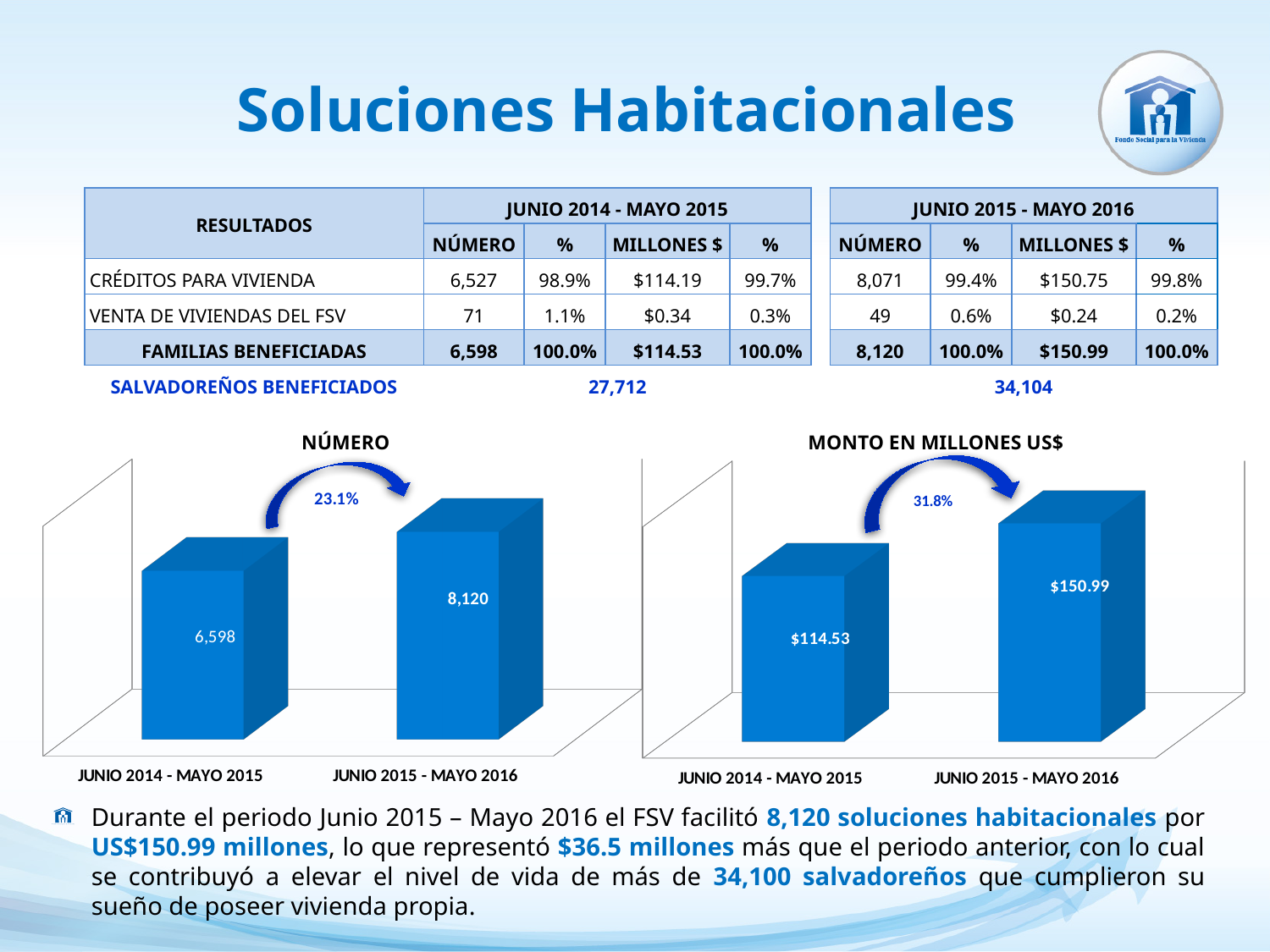
In the NÚMERO chart, what is the value for JUNIO 2015 - MAYO 2016? 8,120 In the MONTO EN MILLONES US$ chart, do the values rise or fall from JUNIO 2014 - MAYO 2015 to JUNIO 2015 - MAYO 2016? Rise In the NÚMERO chart, what is the value for JUNIO 2014 - MAYO 2015? 6,598 In the MONTO EN MILLONES US$ chart, what is the difference between the JUNIO 2015 - MAYO 2016 value and the JUNIO 2014 - MAYO 2015 value? $36.46 In the MONTO EN MILLONES US$ chart, what is the value for JUNIO 2015 - MAYO 2016? $150.99 What type of chart is the MONTO EN MILLONES US$ chart? Bar chart In the MONTO EN MILLONES US$ chart, which period has the lower value? JUNIO 2014 - MAYO 2015 In the MONTO EN MILLONES US$ chart, what is the value for JUNIO 2014 - MAYO 2015? $114.53 In the NÚMERO chart, which period has the higher value? JUNIO 2015 - MAYO 2016 In the NÚMERO chart, what is the difference between the JUNIO 2015 - MAYO 2016 value and the JUNIO 2014 - MAYO 2015 value? 1,522 What percentage increase is annotated on the NÚMERO chart? 23.1% How many bars are shown in the NÚMERO chart? 2